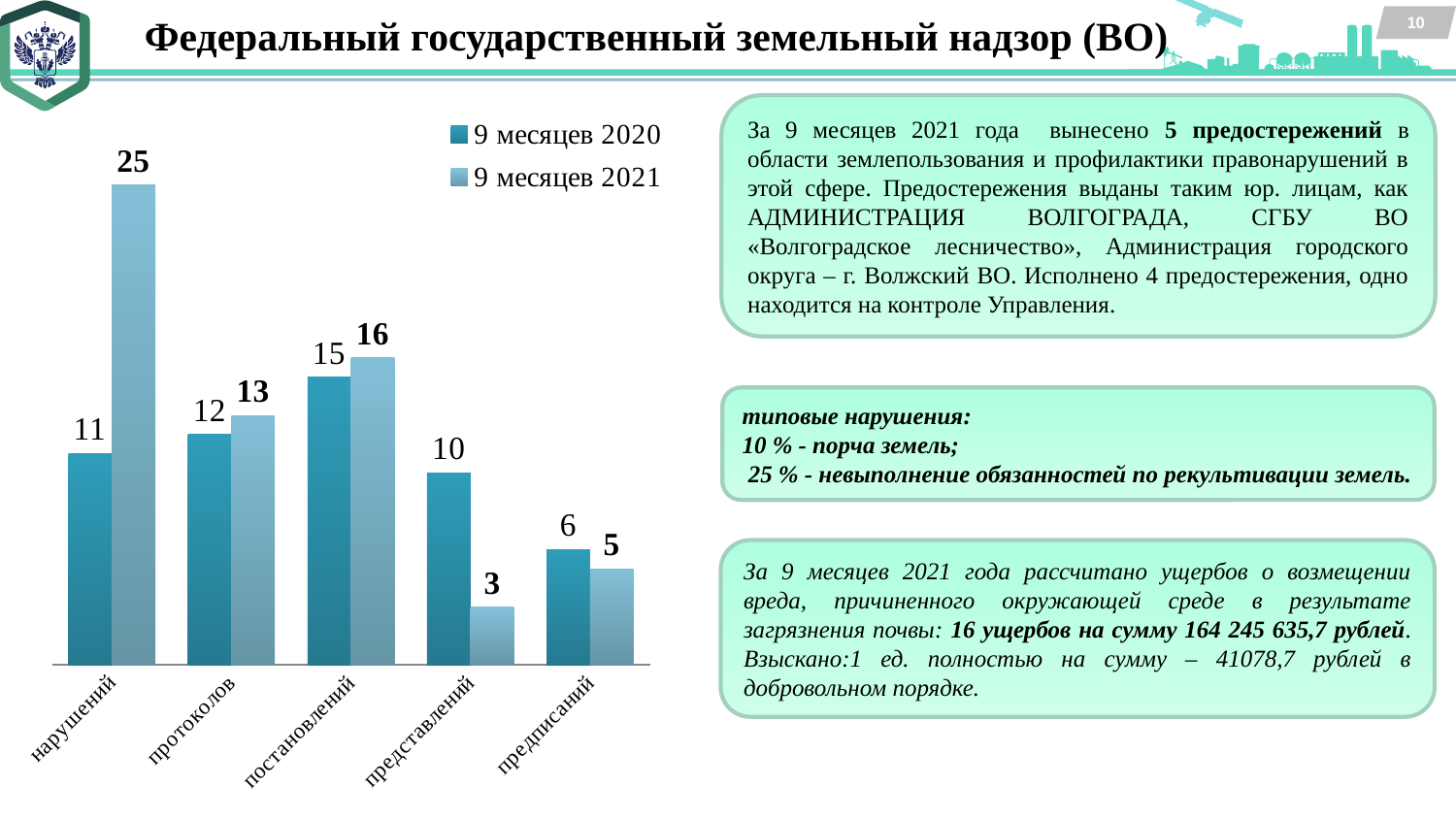
Which series is shown in the lighter blue colour in the chart? 9 месяцев 2021 What is the difference between the 9 месяцев 2021 and 9 месяцев 2020 values for нарушений? 14 What type of chart is shown on the slide? bar chart What is the difference between the 9 месяцев 2020 and 9 месяцев 2021 values for представлений? 7 How many series does the chart legend list? 2 Which is larger for представлений: the 9 месяцев 2020 value or the 9 месяцев 2021 value? 9 месяцев 2020 What is the value for представлений in the 9 месяцев 2020 series? 10 What is the value for предписаний in the 9 месяцев 2021 series? 5 How many categories are shown on the x axis of the chart? 5 What is the value for нарушений in the 9 месяцев 2021 series? 25 Which category has the highest value in the 9 месяцев 2021 series? нарушений Which category has the lowest value in the 9 месяцев 2020 series? предписаний